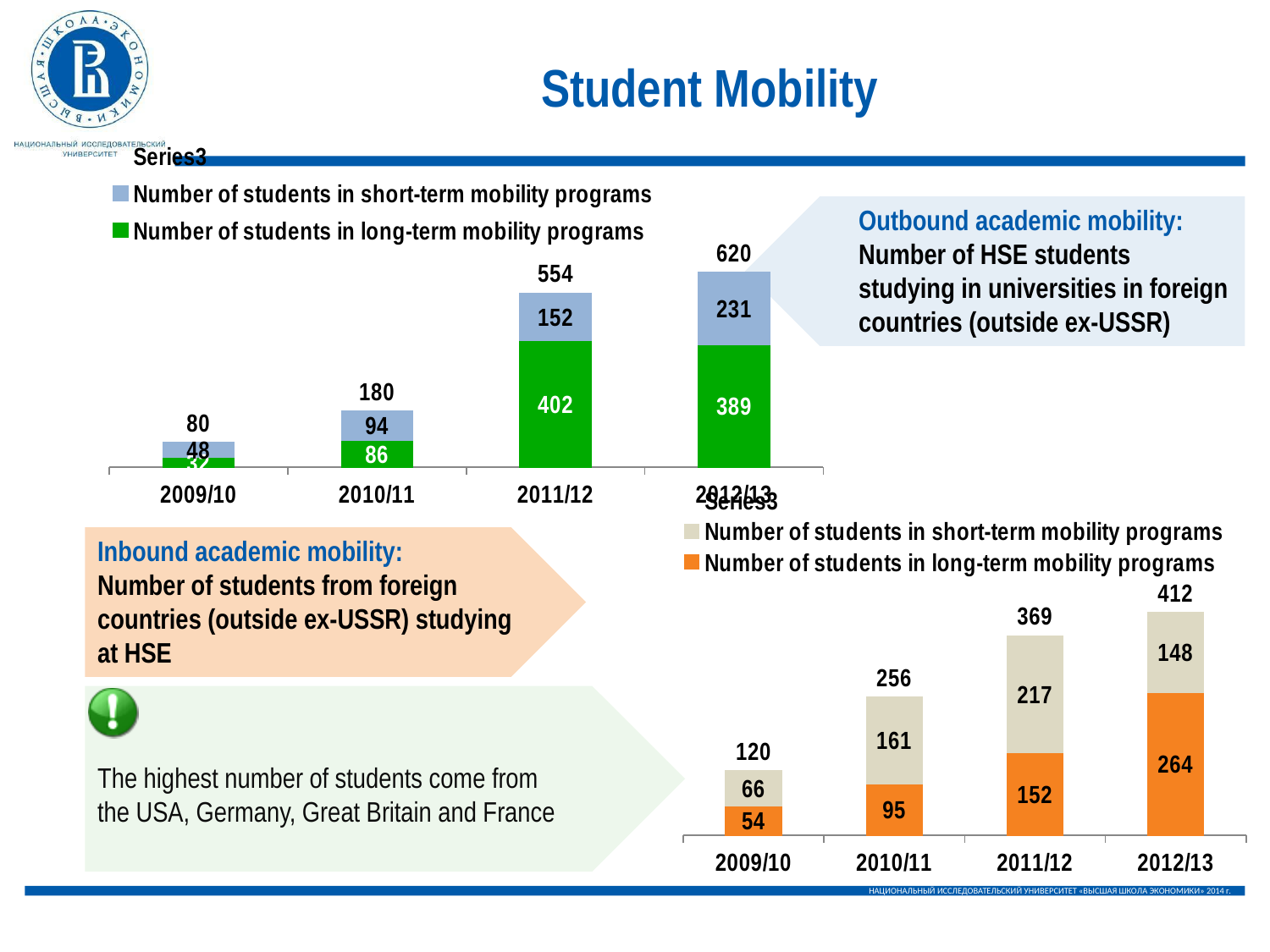
In the inbound academic mobility chart (bottom right), how many students were in long-term mobility programs in 2012/13? 264 In the outbound academic mobility chart (top left), what is the difference between the short-term values for 2012/13 and 2011/12? 79 In the inbound academic mobility chart (bottom right), do the total values rise or fall from 2009/10 to 2012/13? rise In the outbound academic mobility chart (top left), how many students were in short-term mobility programs in 2012/13? 231 In the inbound academic mobility chart (bottom right), what is the total number of students for 2010/11? 256 In the outbound academic mobility chart (top left), what is the total number of students for 2012/13? 620 In the outbound academic mobility chart (top left), how many years are shown on the x axis? 4 In the outbound academic mobility chart (top left), how many students were in long-term mobility programs in 2011/12? 402 What kind of chart is the inbound academic mobility chart (bottom right)? stacked bar chart In the inbound academic mobility chart (bottom right), which year has the lowest total number of students? 2009/10 In the outbound academic mobility chart (top left), which year has the highest total number of students? 2012/13 In the inbound academic mobility chart (bottom right), is the short-term value larger in 2011/12 or in 2012/13? 2011/12